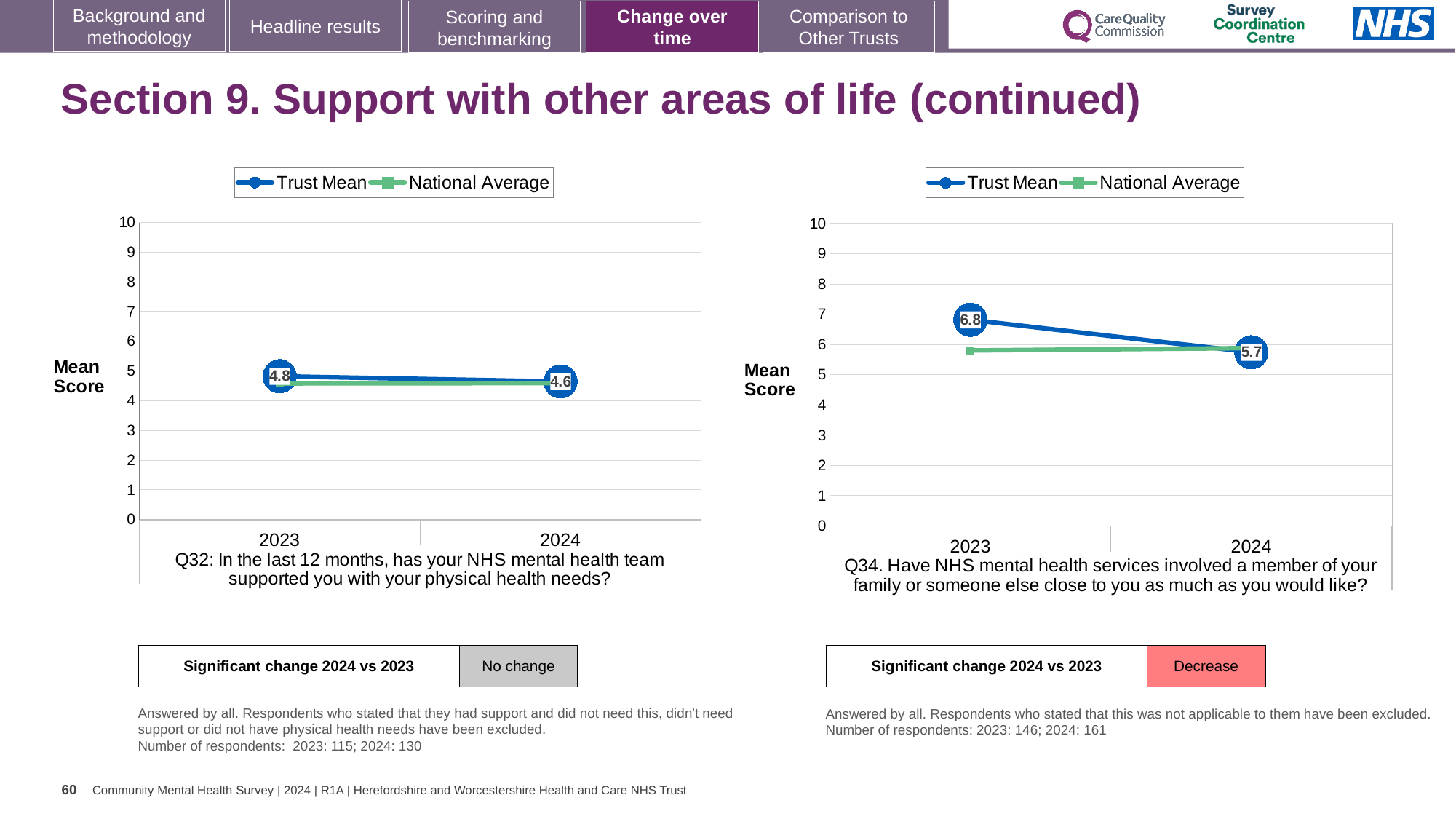
In the Q34 chart (right), which is larger in 2023: the Trust Mean or the National Average? Trust Mean In the Q34 chart (right), what is the Trust Mean score for 2023? 6.8 What type of chart is used for Q32 on the left? line chart In the Q34 chart (right), does the Trust Mean rise or fall from 2023 to 2024? fall In the Q34 chart (right), by how much did the Trust Mean fall from 2023 to 2024? 1.1 In the Q34 chart (right), is the National Average value for 2023 greater or less than 7? less In the Q32 chart (left), what is the Trust Mean score for 2024? 4.6 How many series does the legend of the Q34 chart (right) list? 2 In the Q32 chart (left), what is the Trust Mean score for 2023? 4.8 In the Q34 chart (right), what is the Trust Mean score for 2024? 5.7 In the Q32 chart (left), what is the difference between the Trust Mean in 2023 and in 2024? 0.2 How many years are shown on the x axis of the Q32 chart (left)? 2